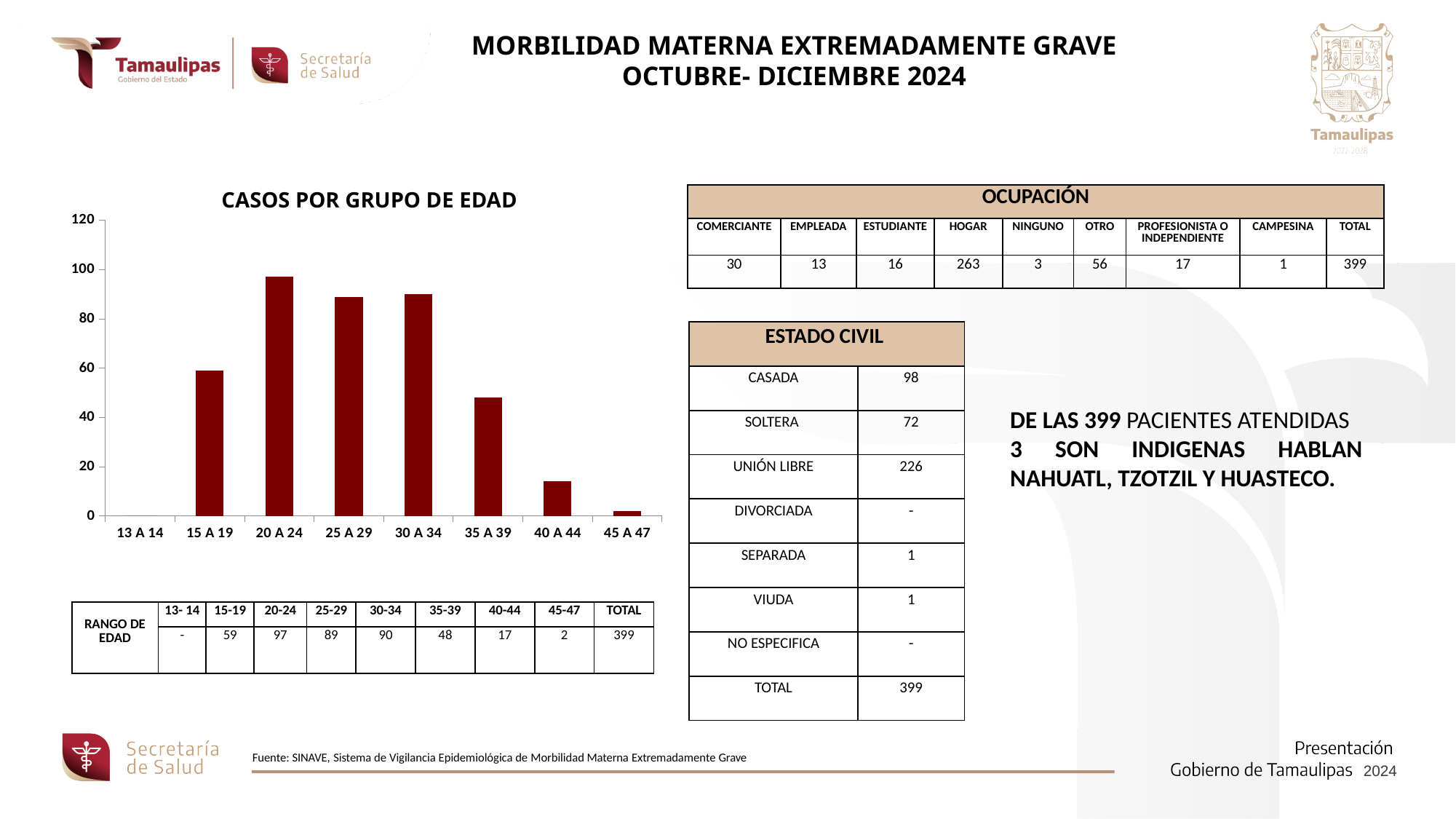
According to the table below the chart, how many cases are in the 20-24 age group? 97 According to the table below the chart, how many cases are in the 15-19 age group? 59 Using the table values, what is the difference between the 20-24 and 15-19 age groups? 38 Which age group has the highest bar in the chart? 20 A 24 What is the title of the chart on the slide? CASOS POR GRUPO DE EDAD According to the table below the chart, how many cases are in the 35-39 age group? 48 Which is larger, the bar for 15 A 19 or the bar for 35 A 39? 15 A 19 Is the value for 15 A 19 greater or less than 40? greater What type of chart is 'CASOS POR GRUPO DE EDAD'? bar chart How many age-group categories are shown on the x axis of the chart? 8 Is the value for 40 A 44 greater or less than 20? less Do the bars rise or fall from 20 A 24 to 45 A 47? fall